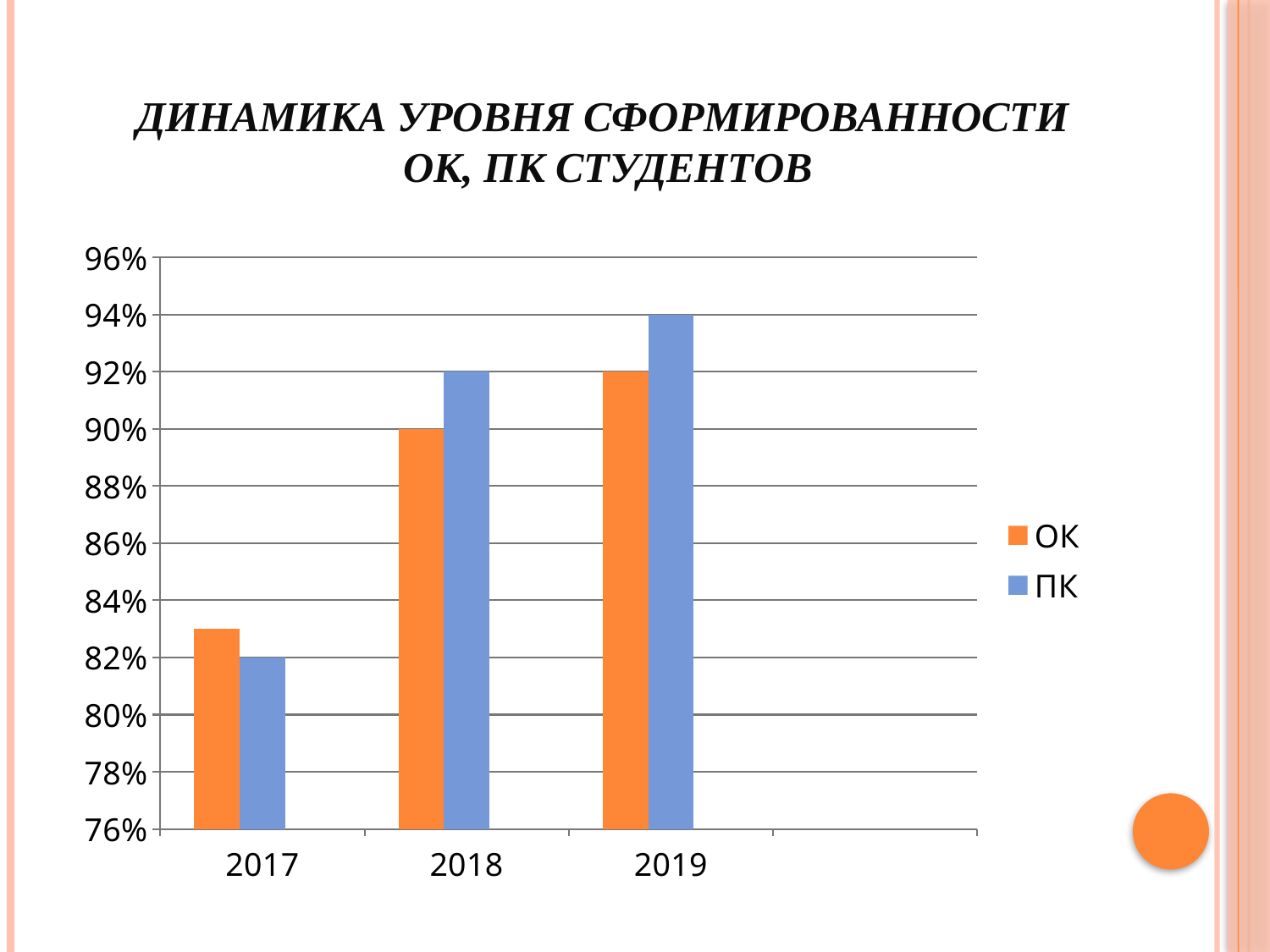
Do the ПК values rise or fall from 2017 to 2019? rise How many series does the legend list? 2 Which year has the lowest value for ОК? 2017 What is the value for ПК in 2017? 82% What is the value for ОК in 2018? 90% Is the value for ОК in 2017 greater or less than 84%? less How many years are shown on the x axis? 3 What kind of chart is shown on the slide? bar chart What is the value for ПК in 2019? 94% Which year has the highest value for ПК? 2019 Which is larger in 2018, ОК or ПК? ПК What is the difference between the ПК values for 2019 and 2017? 12%